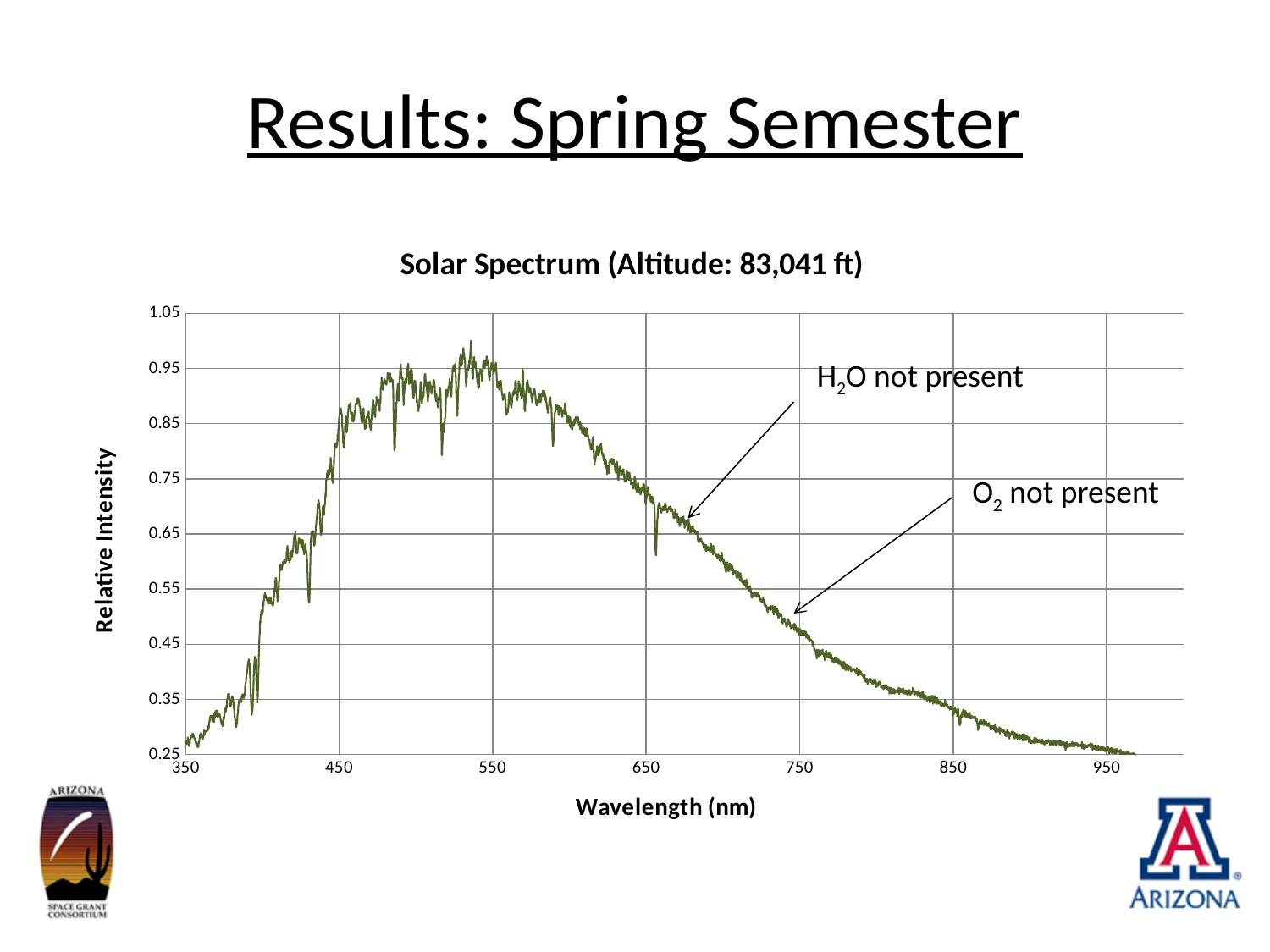
Does the relative intensity rise or fall as wavelength increases from 350 nm to 550 nm? rise Is the relative intensity at 850 nm greater or less than 0.45? less Is the relative intensity at 950 nm greater or less than 0.35? less Is the relative intensity at 350 nm greater or less than 0.35? less Which is larger, the relative intensity at 550 nm or at 850 nm? 550 nm Does the relative intensity rise or fall as wavelength increases from 550 nm to 950 nm? fall What is the label of the x axis? Wavelength (nm) What is the title of the chart? Solar Spectrum (Altitude: 83,041 ft) What kind of chart is shown on the slide? line chart